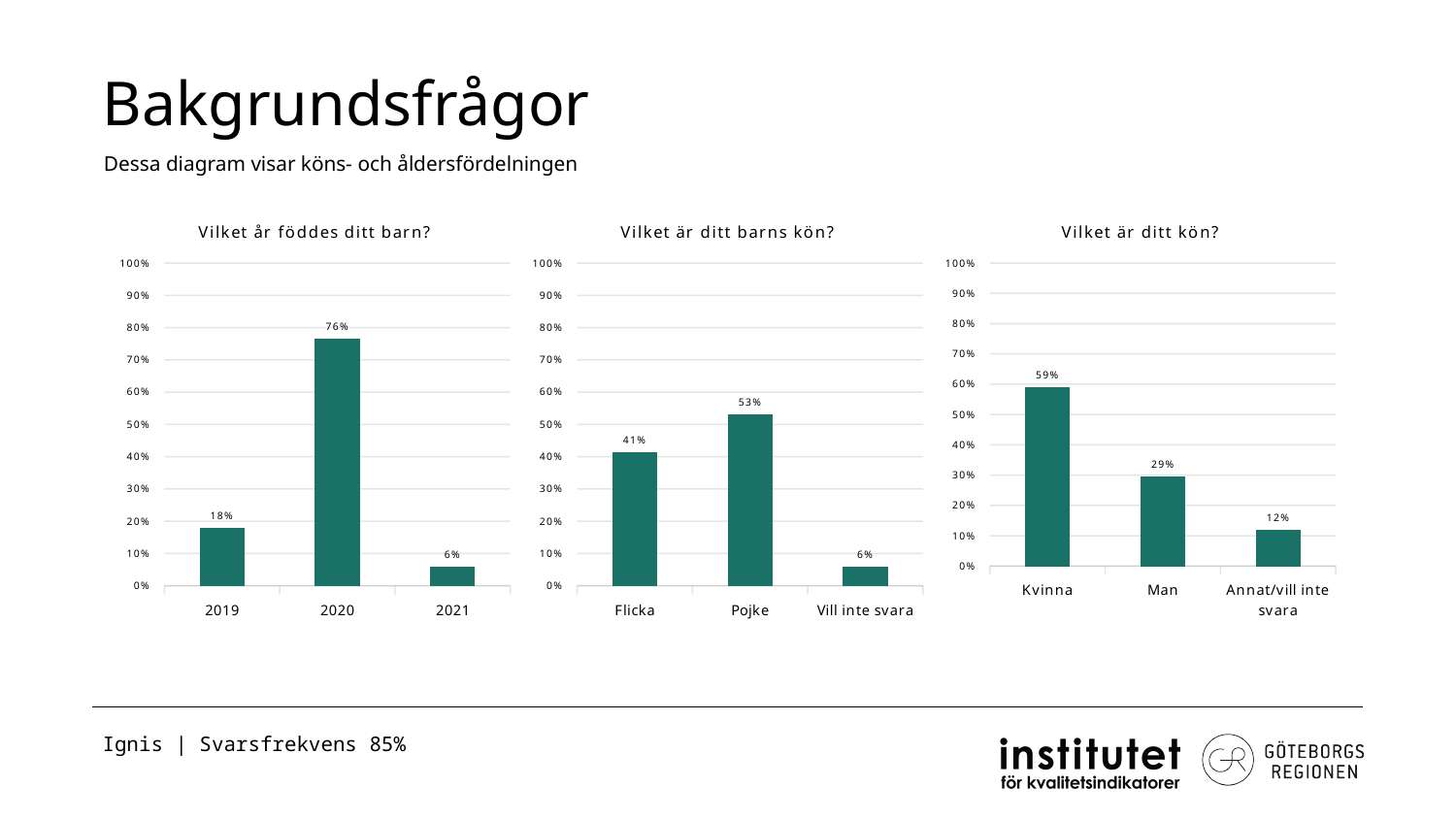
In the chart 'Vilket är ditt kön?', is the value for Kvinna greater or less than 50%? greater In the chart 'Vilket är ditt kön?', what is the value for Man? 29% In the chart 'Vilket år föddes ditt barn?', what is the value for 2020? 76% In the chart 'Vilket år föddes ditt barn?', what is the difference between the values for 2020 and 2019? 58% How many charts are shown on the slide? 3 In the chart 'Vilket år föddes ditt barn?', which year has the lowest value? 2021 In the chart 'Vilket är ditt barns kön?', which is larger, Flicka or Pojke? Pojke In the chart 'Vilket är ditt barns kön?', how many categories are shown? 3 In the chart 'Vilket är ditt kön?', what is the difference between the values for Kvinna and Man? 30% In the chart 'Vilket är ditt barns kön?', what is the value for Flicka? 41% In the chart 'Vilket är ditt barns kön?', which category has the highest value? Pojke What kind of chart is 'Vilket är ditt kön?'? Bar chart